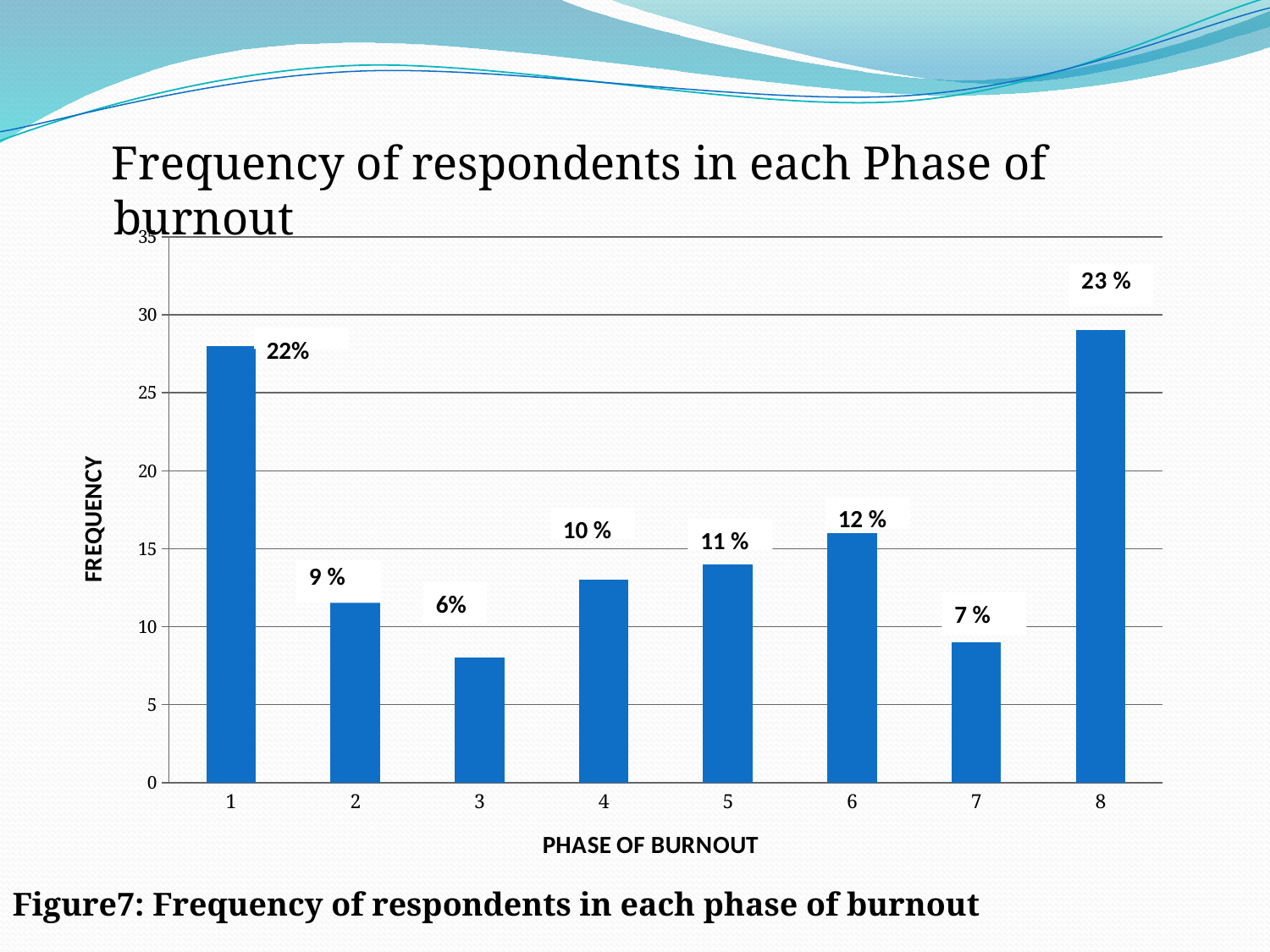
What percentage label is shown for phase 3? 6% Which has a higher frequency, phase 2 or phase 5? phase 5 Which phase of burnout has the highest frequency? 8 What percentage label is shown for phase 1? 22% What kind of chart is shown on the slide? bar chart What percentage label is shown for phase 6? 12 % What is the label of the y axis? FREQUENCY Which phase of burnout has the lowest frequency? 3 Is the frequency for phase 7 greater or less than 10? less How many phases of burnout are shown on the x axis? 8 Is the frequency for phase 1 greater or less than 25? greater What percentage label is shown for phase 8? 23 %